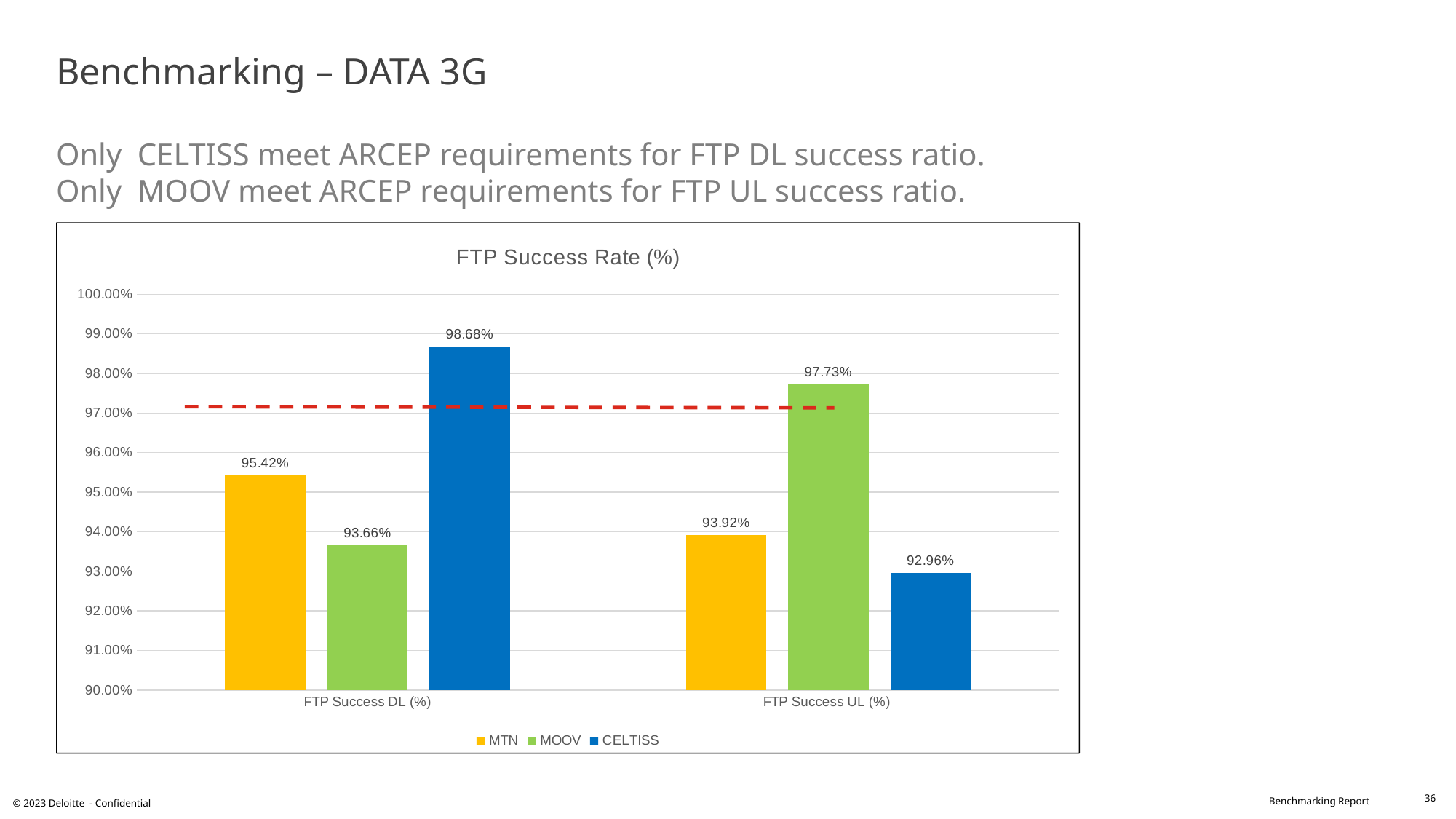
Which is larger: MTN's FTP Success DL (%) or MTN's FTP Success UL (%)? FTP Success DL (%) What is the difference between CELTISS and MOOV for FTP Success DL (%)? 5.02% Which operator has the lowest FTP Success UL (%)? CELTISS What is the title of the chart? FTP Success Rate (%) What is the FTP Success UL (%) value for MOOV? 97.73% What is the FTP Success DL (%) value for MTN? 95.42% What is the FTP Success DL (%) value for CELTISS? 98.68% Is the FTP Success UL (%) value for MOOV greater or less than 97.00%? greater Which operator has the highest FTP Success DL (%)? CELTISS What kind of chart is shown on the slide? Bar chart What is the FTP Success UL (%) value for CELTISS? 92.96% How many series does the legend list? 3